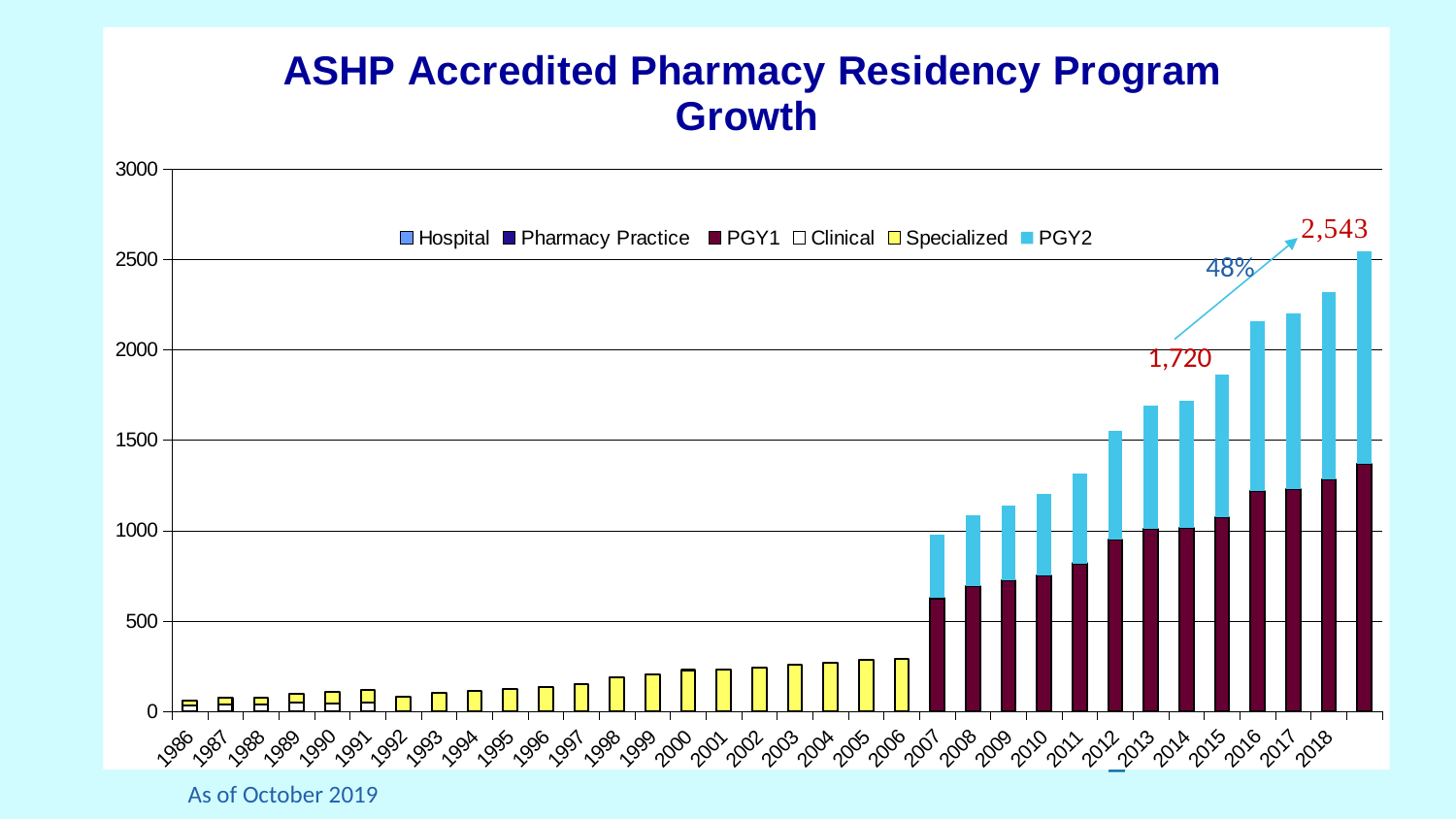
What percentage growth is annotated on the arrow between the 2013 and 2018 bars? 48% Do the bar totals generally rise or fall from 1986 to 2018? Rise Is the total for 2018 greater or less than 2500? less How many series does the legend list? 6 Is the total for 2006 greater or less than 500? less How many years are shown along the x axis? 33 What kind of chart is shown on the slide? Stacked bar chart Which year has the taller bar, 2006 or 2007? 2007 Is the total for 2016 greater or less than 2000? greater What value is labelled at the start of the growth arrow? 1,720